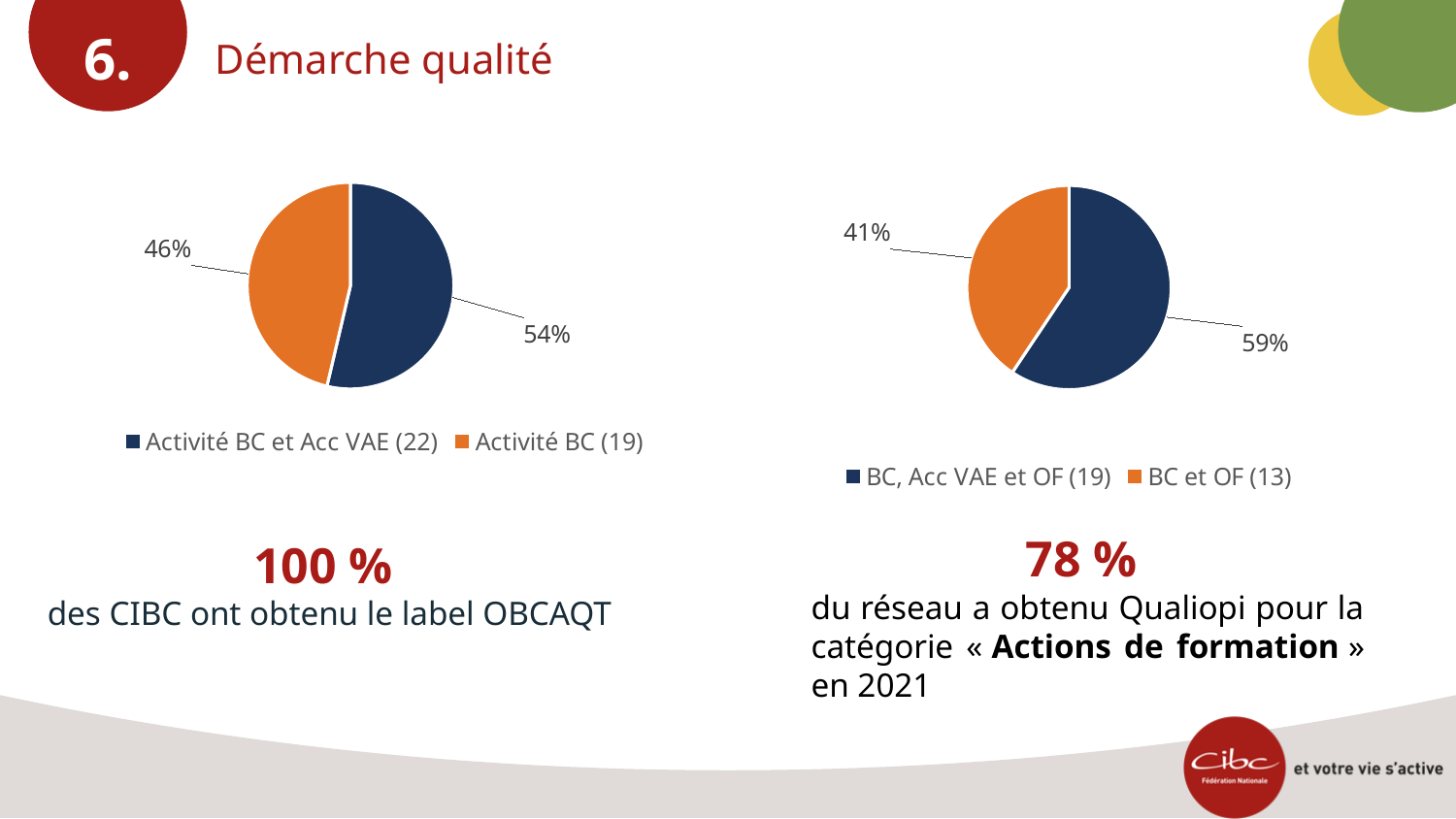
In the left pie chart, what is the difference in percentage points between the 'Activité BC et Acc VAE (22)' slice and the 'Activité BC (19)' slice? 8 In the right pie chart, what share does the slice 'BC et OF (13)' represent? 41% In the right pie chart, which slice is the smallest? BC et OF (13) In the left pie chart, which slice is the largest? Activité BC et Acc VAE (22) In the left pie chart, what share does the slice 'Activité BC (19)' represent? 46% In the left pie chart, what colour is the 'Activité BC (19)' slice? Orange In the right pie chart, what share does the slice 'BC, Acc VAE et OF (19)' represent? 59% In the right pie chart, what is the difference in percentage points between the 'BC, Acc VAE et OF (19)' slice and the 'BC et OF (13)' slice? 18 What type of chart is the left chart on the slide? Pie chart How many slices does the right pie chart have? 2 Which is larger: the 'Activité BC (19)' slice in the left pie chart or the 'BC et OF (13)' slice in the right pie chart? Activité BC (19)